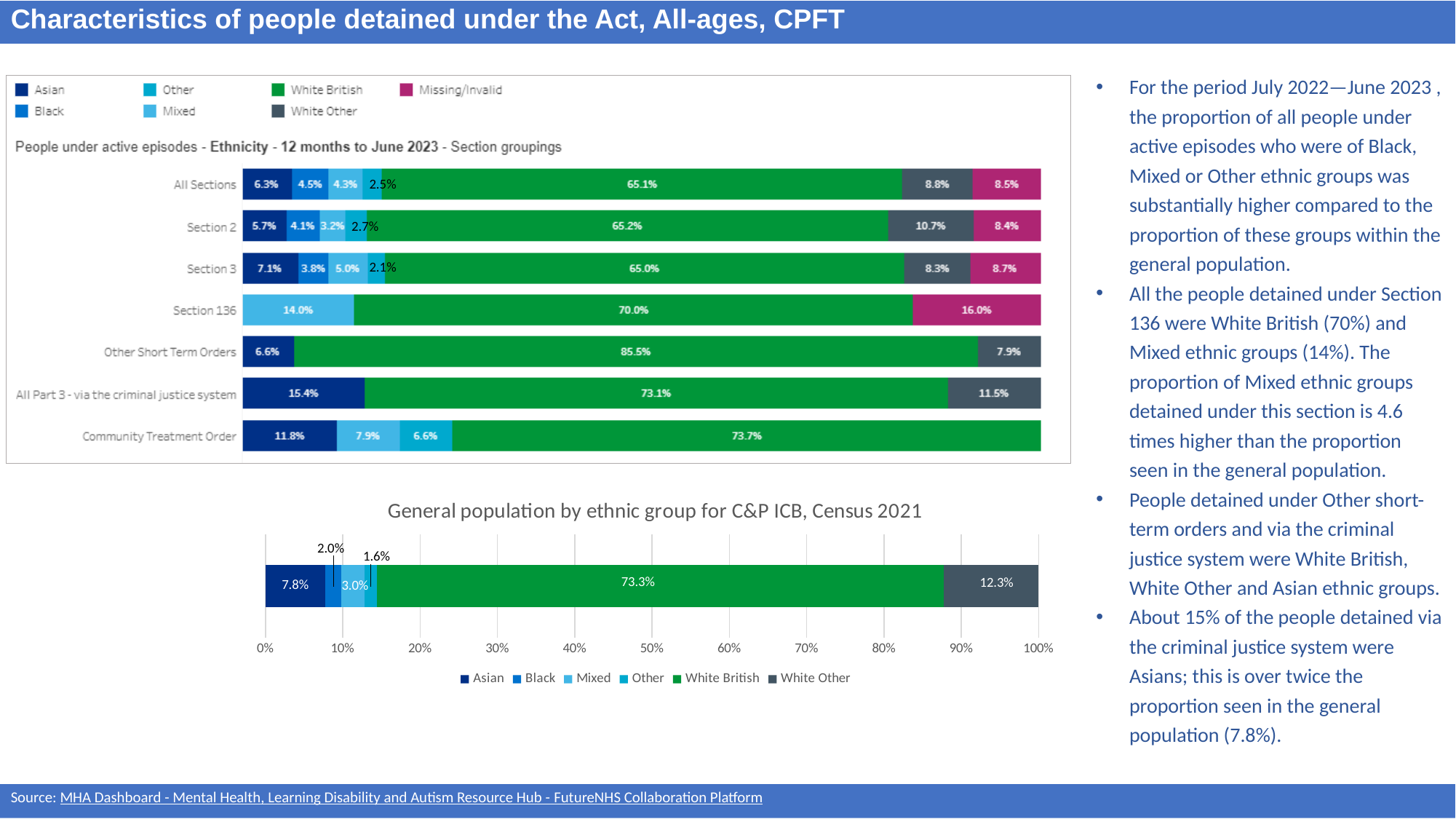
In the top chart (People under active episodes - Ethnicity), is the White Other percentage larger for Section 2 or Section 3? Section 2 In the top chart (People under active episodes - Ethnicity), what is the Mixed percentage for Section 136? 14.0% In the top chart (People under active episodes - Ethnicity), how many ethnic groups does the legend list? 7 In the top chart (People under active episodes - Ethnicity), what is the White British percentage for Section 136? 70.0% In the top chart (People under active episodes - Ethnicity), how many section groupings are shown? 7 In the bottom chart (General population by ethnic group for C&P ICB, Census 2021), how many ethnic groups does the legend list? 6 In the top chart (People under active episodes - Ethnicity), what is the Asian percentage for All Part 3 - via the criminal justice system? 15.4% In the bottom chart (General population by ethnic group for C&P ICB, Census 2021), what is the White Other percentage? 12.3% In the bottom chart (General population by ethnic group for C&P ICB, Census 2021), what is the difference between the White British and White Other percentages? 61.0% In the bottom chart (General population by ethnic group for C&P ICB, Census 2021), what is the Asian percentage? 7.8% In the top chart (People under active episodes - Ethnicity), what is the Missing/Invalid percentage for Section 2? 8.4% In the top chart (People under active episodes - Ethnicity), which section grouping has the highest White British percentage? Other Short Term Orders